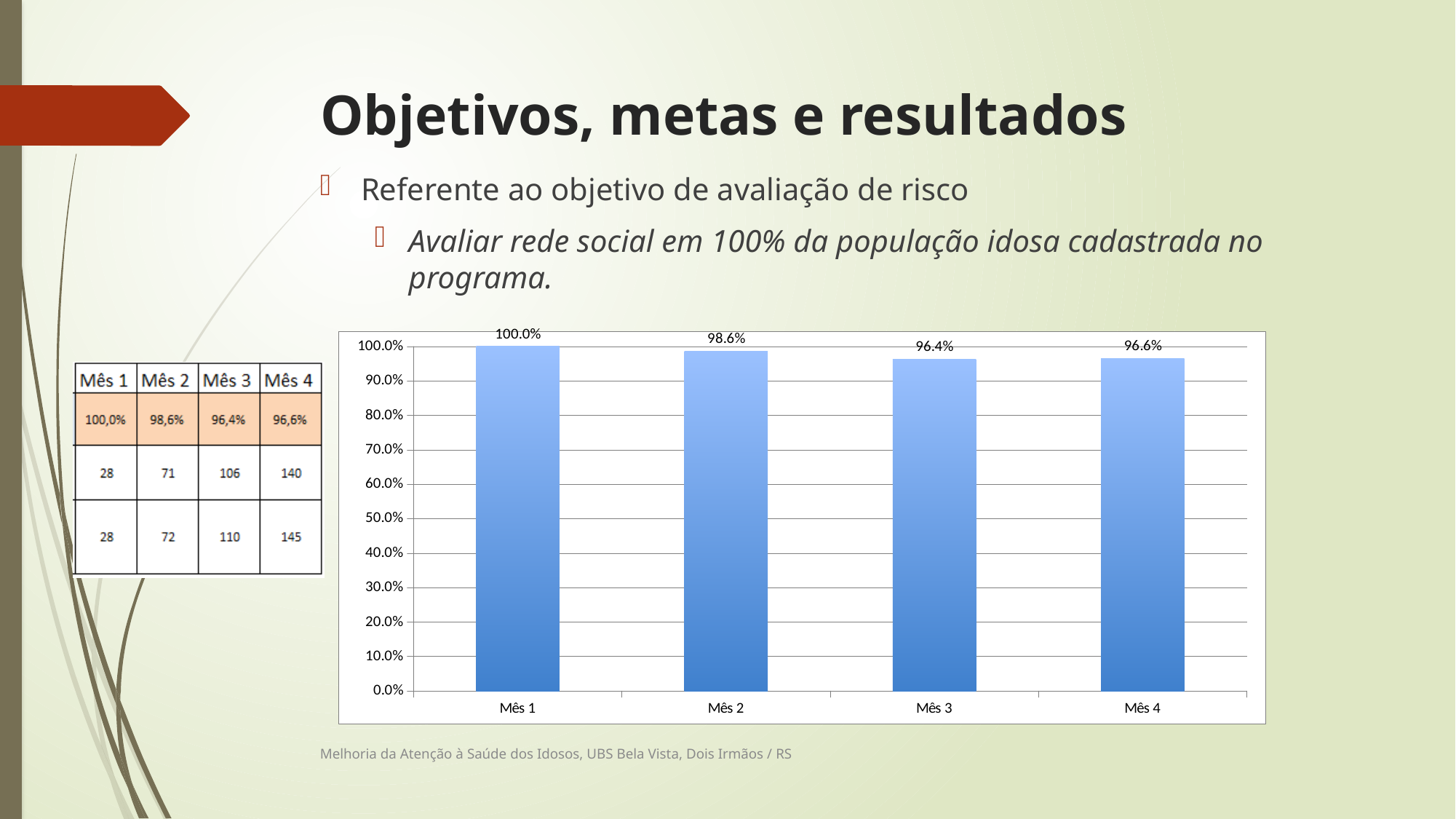
Which month has the lowest value in the bar chart? Mês 3 What is the value for Mês 3 in the bar chart? 96.4% Which month has the highest value in the bar chart? Mês 1 What kind of chart is shown on the slide? bar chart What is the difference between the values for Mês 4 and Mês 3? 0.2% Is the value for Mês 3 greater or less than 90.0%? greater Which is larger, the value for Mês 2 or the value for Mês 3? Mês 2 What is the value for Mês 2 in the bar chart? 98.6% How many months are shown on the x axis of the bar chart? 4 What is the value for Mês 4 in the bar chart? 96.6% What is the value for Mês 1 in the bar chart? 100.0% What is the difference between the values for Mês 1 and Mês 2? 1.4%